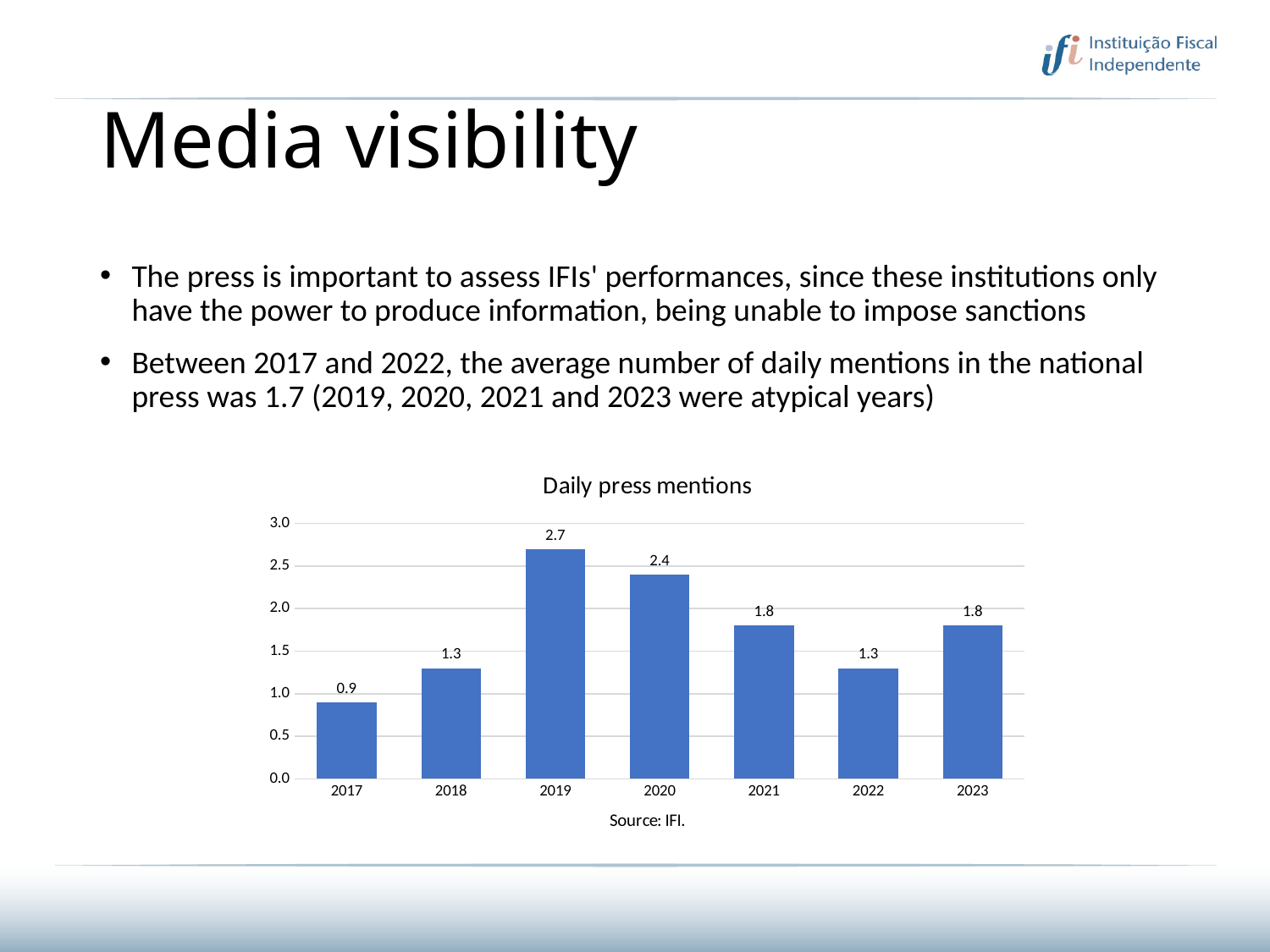
Which is larger in the Daily press mentions chart, the value for 2020 or the value for 2021? 2020 What is the title of the chart on the slide? Daily press mentions What is the value for 2022 in the Daily press mentions chart? 1.3 What is the difference between the values for 2019 and 2020 in the Daily press mentions chart? 0.3 Which year has the highest value in the Daily press mentions chart? 2019 How many years are shown in the Daily press mentions chart? 7 What is the difference between the values for 2021 and 2017 in the Daily press mentions chart? 0.9 What kind of chart is the Daily press mentions chart? bar chart Which year has the lowest value in the Daily press mentions chart? 2017 Is the value for 2019 in the Daily press mentions chart greater or less than 2.5? greater What is the value for 2019 in the Daily press mentions chart? 2.7 What is the value for 2017 in the Daily press mentions chart? 0.9